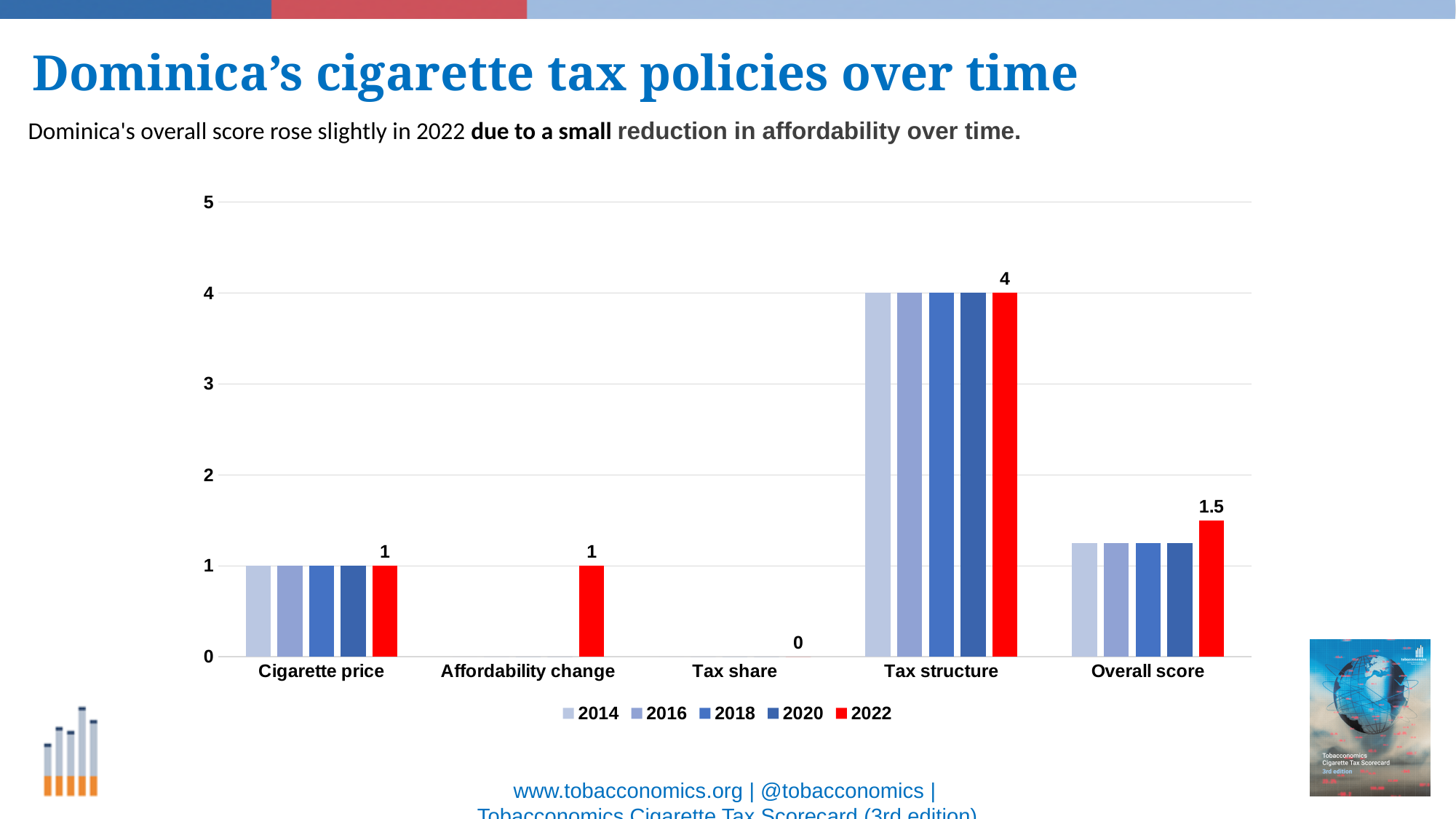
How many series does the legend list? 5 What is the difference between the 2022 values for Tax structure and Overall score? 2.5 What is the value for Tax share in 2022? 0 Is the Overall score for 2020 greater or less than 2? less Which is larger in 2022: Cigarette price or Overall score? Overall score What kind of chart is shown on the slide? bar chart Which category has the highest value in 2022? Tax structure Which category has the lowest value in 2022? Tax share What is the value for Affordability change in 2022? 1 What is the value for Tax structure in 2022? 4 What is the Overall score for 2022? 1.5 How many categories are shown on the x axis? 5